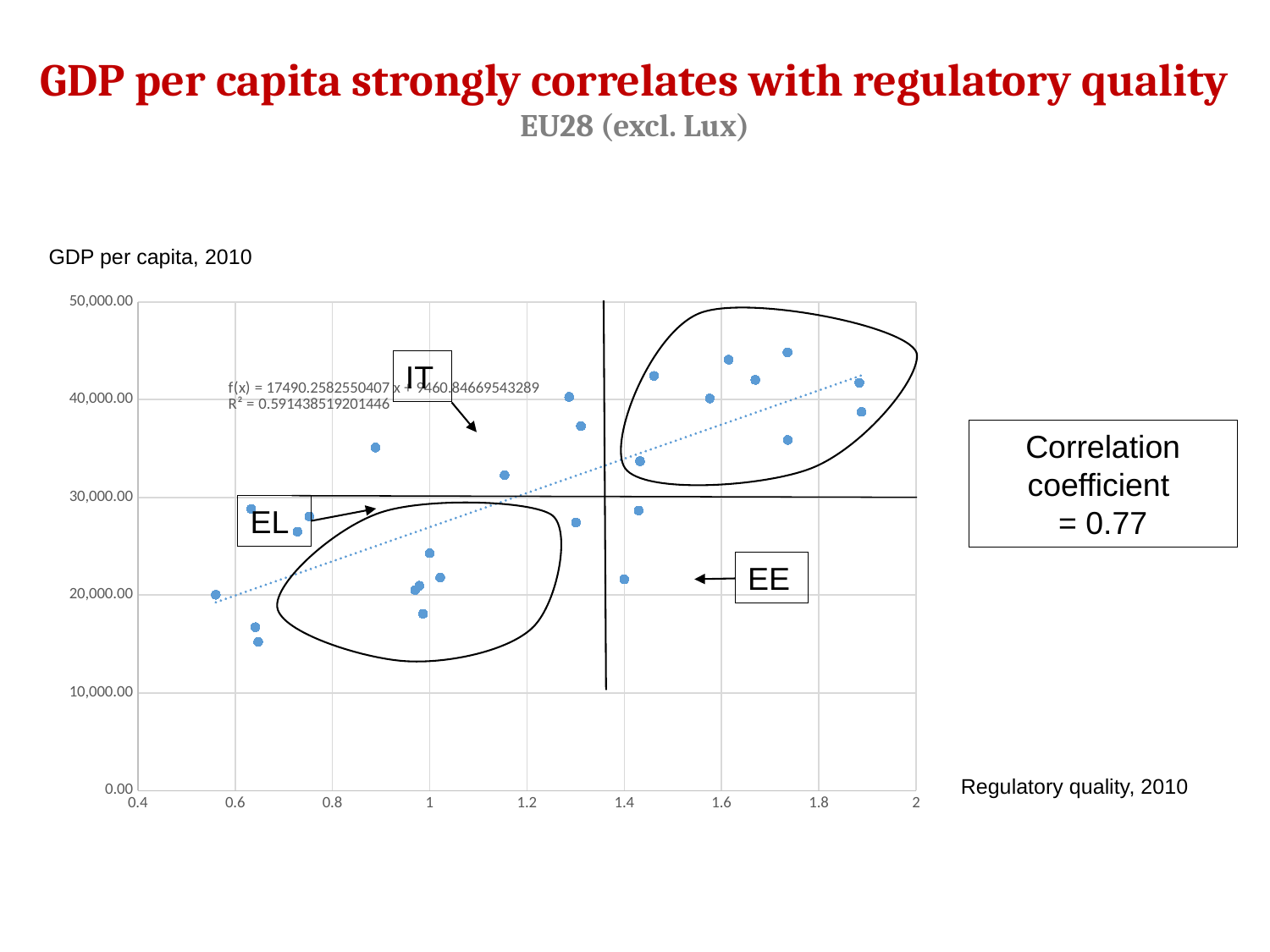
Is the GDP per capita value for the point labelled EL greater or less than 30,000.00? less What is the highest value shown on the vertical axis? 50,000.00 What is the label of the vertical axis? GDP per capita, 2010 What kind of chart is shown on the slide? scatter plot What R² value is shown for the trendline? 0.591438519201446 What is the subtitle of the chart? EU28 (excl. Lux) What correlation coefficient is stated on the slide? 0.77 What is the label of the horizontal axis? Regulatory quality, 2010 As regulatory quality increases along the x axis, does GDP per capita generally rise or fall? rise Is the regulatory quality value for the point labelled EE greater or less than 1.2? greater Is the regulatory quality value for the point labelled EL greater or less than 1? less